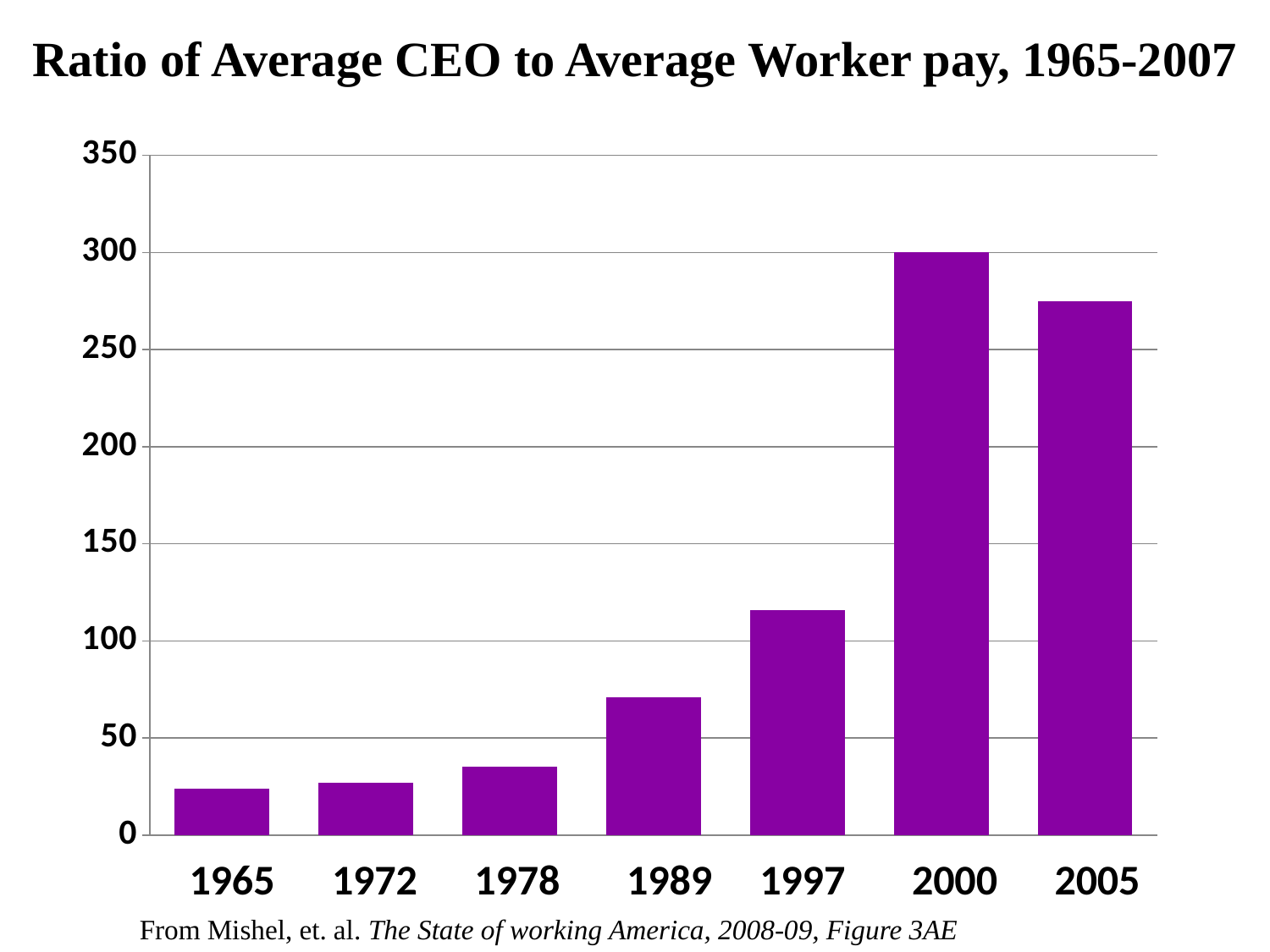
What is the ratio of average CEO to average worker pay in 2000? 300 Is the value for 1997 greater or less than 100? greater Is the value for 1978 greater or less than 50? less Is the value for 1989 greater or less than 100? less How many years are shown on the x axis of the chart? 7 Which year has the highest ratio of average CEO to average worker pay? 2000 What is the title of the chart? Ratio of Average CEO to Average Worker pay, 1965-2007 Which is larger, the value for 2000 or the value for 2005? 2000 What kind of chart is shown on the slide? bar chart Do the values generally rise or fall from 1965 to 2000? rise